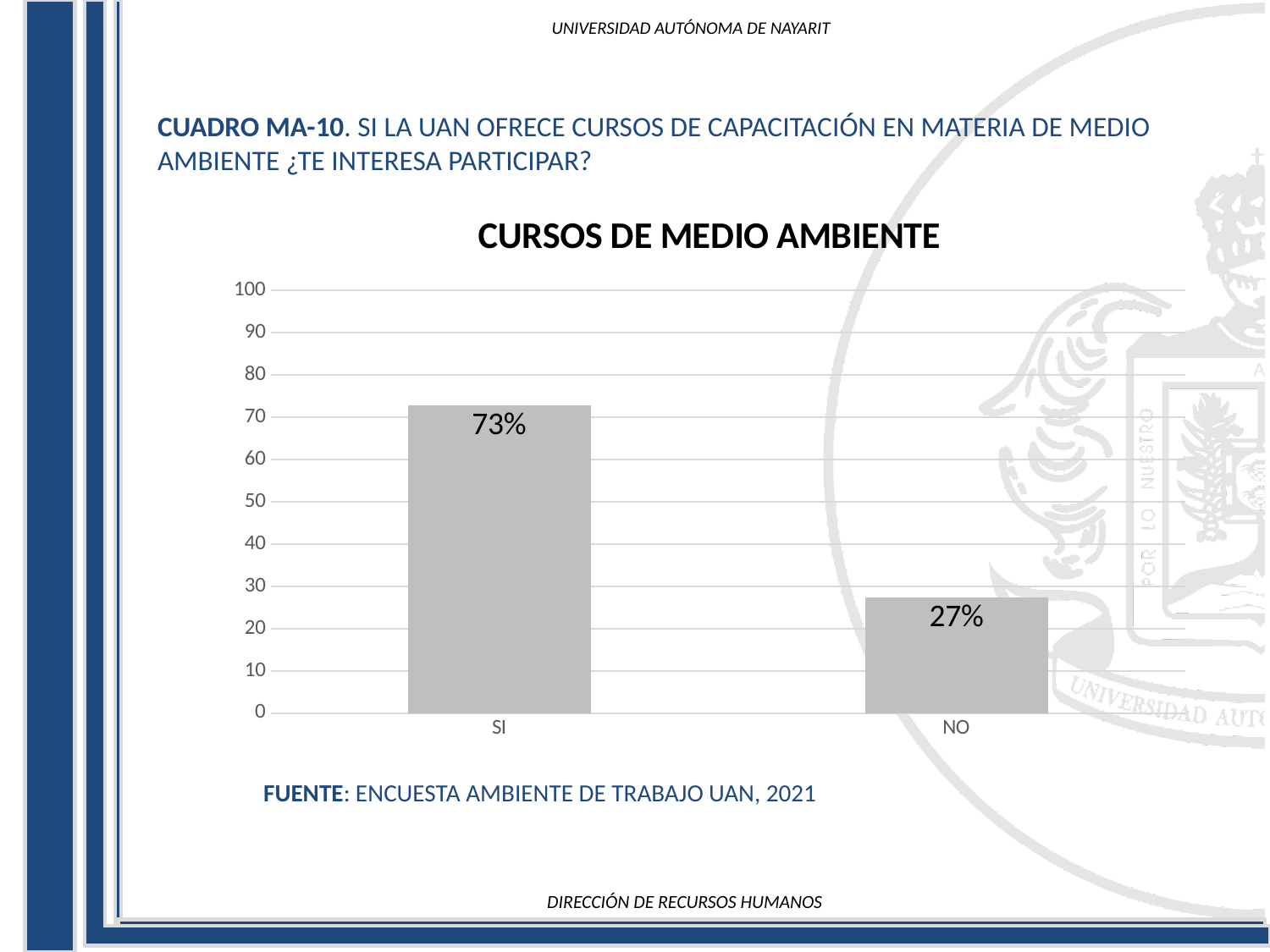
What is the title of the chart? CURSOS DE MEDIO AMBIENTE Is the value for SI greater or less than 70? greater How many categories are shown in the chart? 2 Which category has the lowest value? NO Which category has the highest value? SI What kind of chart is shown on the slide? bar chart What is the value for NO in the chart? 27% What is the value for SI in the chart? 73% What is the highest value shown on the vertical axis? 100 Which is larger, the value for SI or the value for NO? SI What is the difference between the values for SI and NO? 46% Is the value for NO greater or less than 30? less